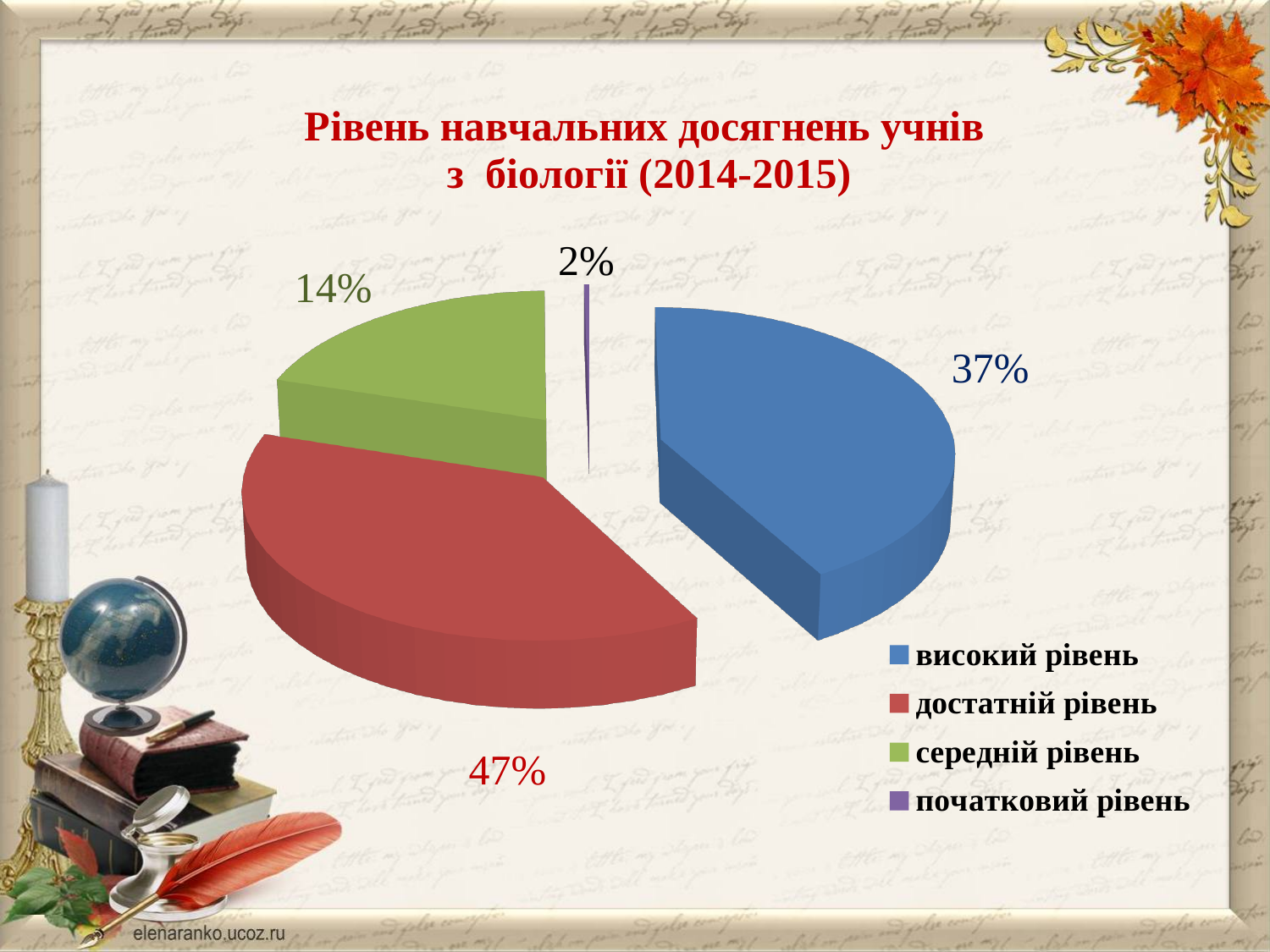
What is the title of the chart? Рівень навчальних досягнень учнів з біології (2014-2015) What share of the pie does the 'середній рівень' slice represent? 14% What share of the pie does the 'достатній рівень' slice represent? 47% What share of the pie does the 'високий рівень' slice represent? 37% What is the difference in percentage points between 'достатній рівень' and 'високий рівень'? 10% What type of chart is shown on the slide? pie chart Which category has the smallest slice of the pie? початковий рівень Which is larger, the share for 'високий рівень' or the share for 'середній рівень'? високий рівень What share of the pie does the 'початковий рівень' slice represent? 2% Which category has the largest slice of the pie? достатній рівень How many categories does the pie chart show? 4 What is the difference in percentage points between 'середній рівень' and 'початковий рівень'? 12%